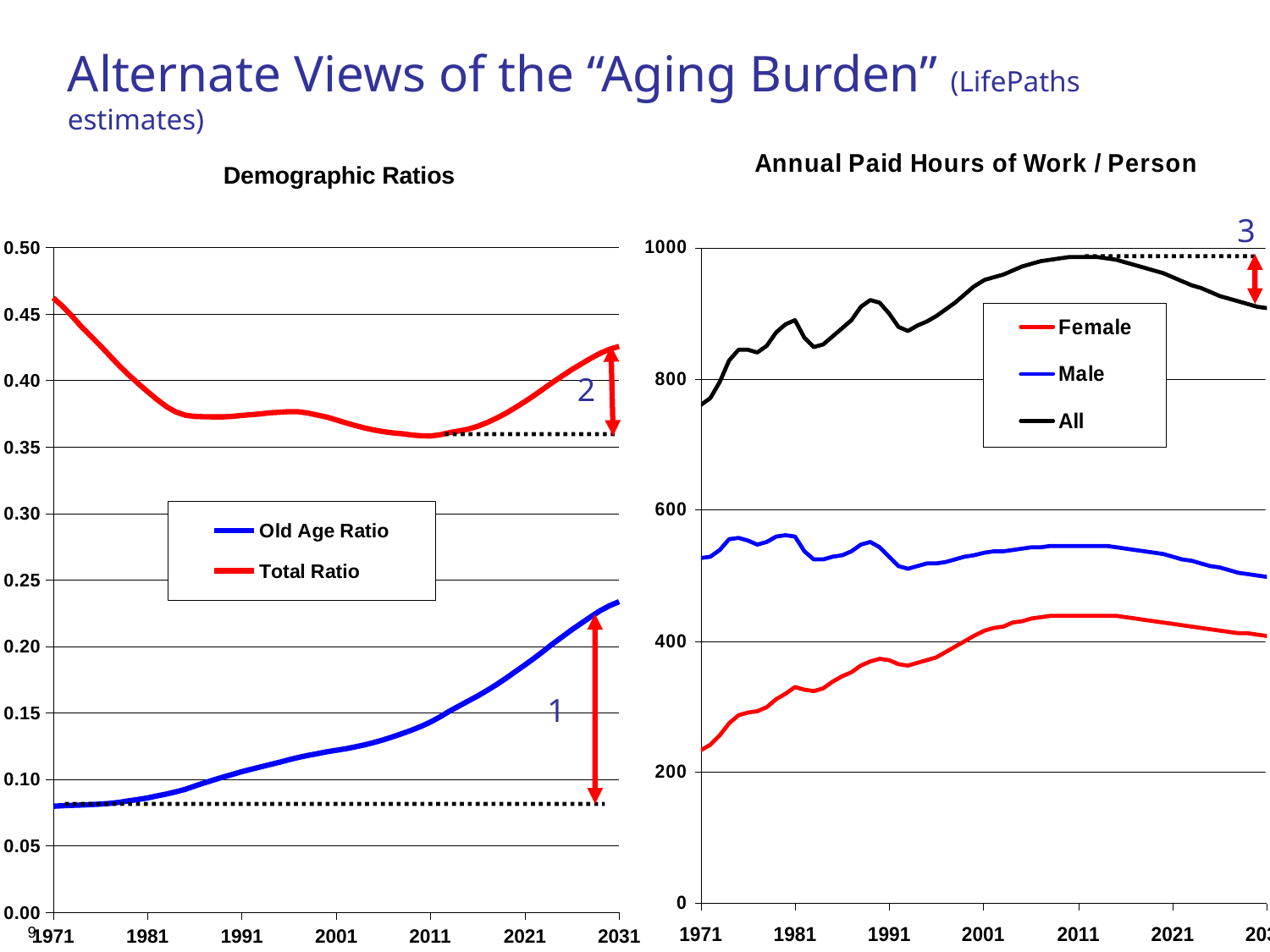
How many series does the legend of the Annual Paid Hours of Work / Person chart list? 3 In the Demographic Ratios chart, does the Old Age Ratio rise or fall from 1971 to 2031? rise In the Annual Paid Hours of Work / Person chart, which series is shown in black? All In the Annual Paid Hours of Work / Person chart, is the All value in 2011 greater or less than 800? greater In the Demographic Ratios chart, which series is higher in 2011, Old Age Ratio or Total Ratio? Total Ratio In the Annual Paid Hours of Work / Person chart, is the Male value in 2031 greater or less than 600? less In the Demographic Ratios chart, is the Total Ratio in 1971 greater or less than 0.45? greater In the Demographic Ratios chart, which series is shown in blue? Old Age Ratio What kind of chart is the Demographic Ratios chart? line chart How many series does the legend of the Demographic Ratios chart list? 2 In the Annual Paid Hours of Work / Person chart, which is larger in 2001, the Male value or the Female value? Male